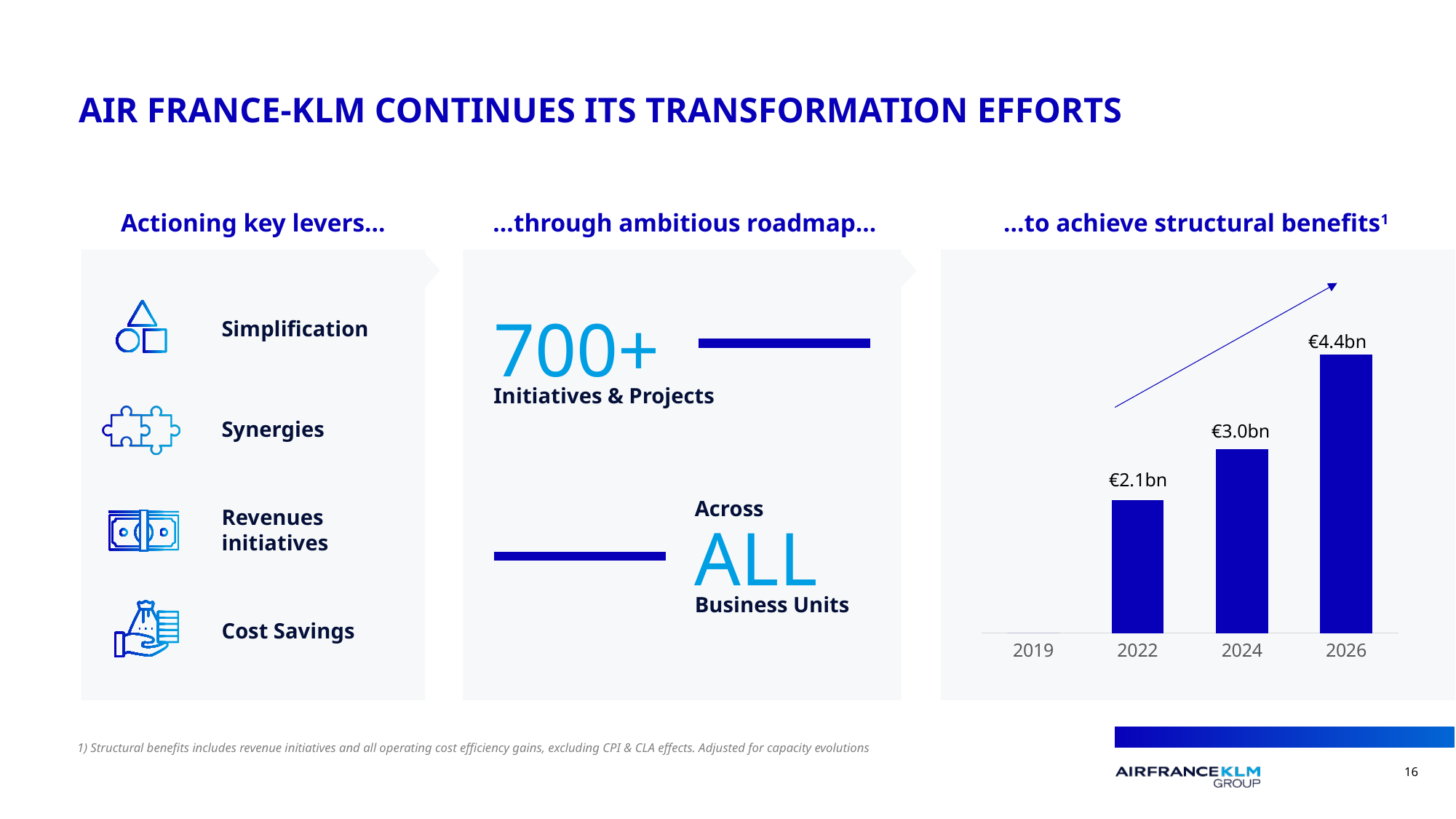
Which year with a plotted bar has the lowest value in the structural benefits chart? 2022 What kind of chart is used to show the structural benefits? Bar chart Do the values in the structural benefits chart rise or fall from 2022 to 2026? Rise Which is larger in the structural benefits chart, the value for 2024 or the value for 2026? 2026 What is the heading above the chart on the right of the slide? ...to achieve structural benefits What is the value shown for 2026 in the structural benefits chart? €4.4bn What is the difference between the 2026 and 2022 values in the structural benefits chart? €2.3bn What is the value shown for 2022 in the structural benefits chart? €2.1bn How many bars are plotted in the structural benefits chart? 3 What is the value shown for 2024 in the structural benefits chart? €3.0bn Which year has the highest value in the structural benefits chart? 2026 What is the difference between the 2024 and 2022 values in the structural benefits chart? €0.9bn